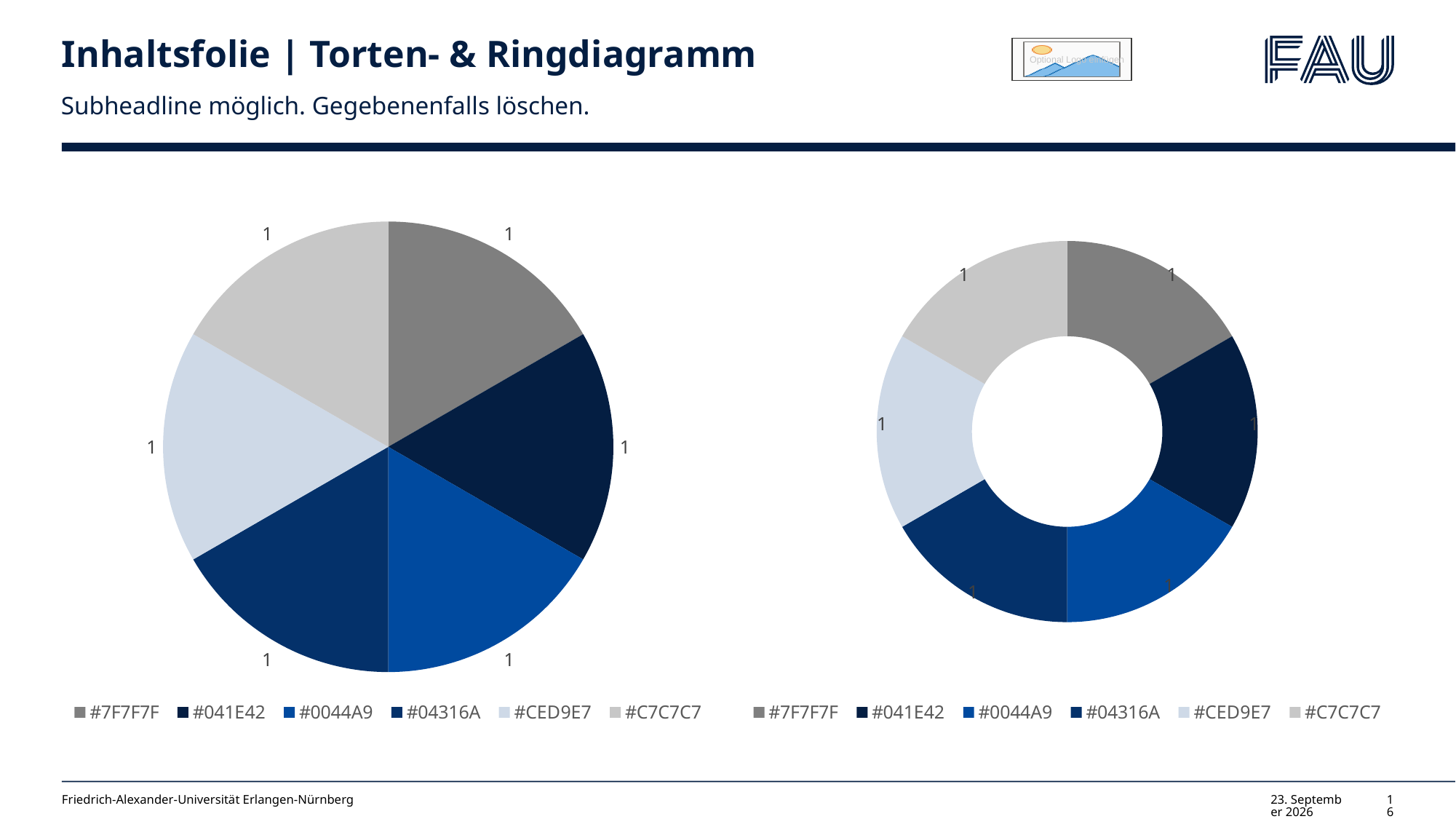
How many entries does the legend of the left pie chart list? 6 What kind of chart is the right chart on the slide? doughnut chart In the left pie chart, what is the total of all slice values? 6 In the left pie chart, which legend entry is listed first? #7F7F7F In the right doughnut chart, are the values for #0044A9 and #04316A equal? yes In the right doughnut chart, how many segments are there? 6 In the left pie chart, how many slices are there? 6 In the right doughnut chart, what is the value labelled on the #CED9E7 segment? 1 What kind of chart is the left chart on the slide? pie chart In the left pie chart, what is the value labelled on the #041E42 slice? 1 In the right doughnut chart, what is the total of all segment values? 6 In the left pie chart, what is the difference between the values for #7F7F7F and #C7C7C7? 0